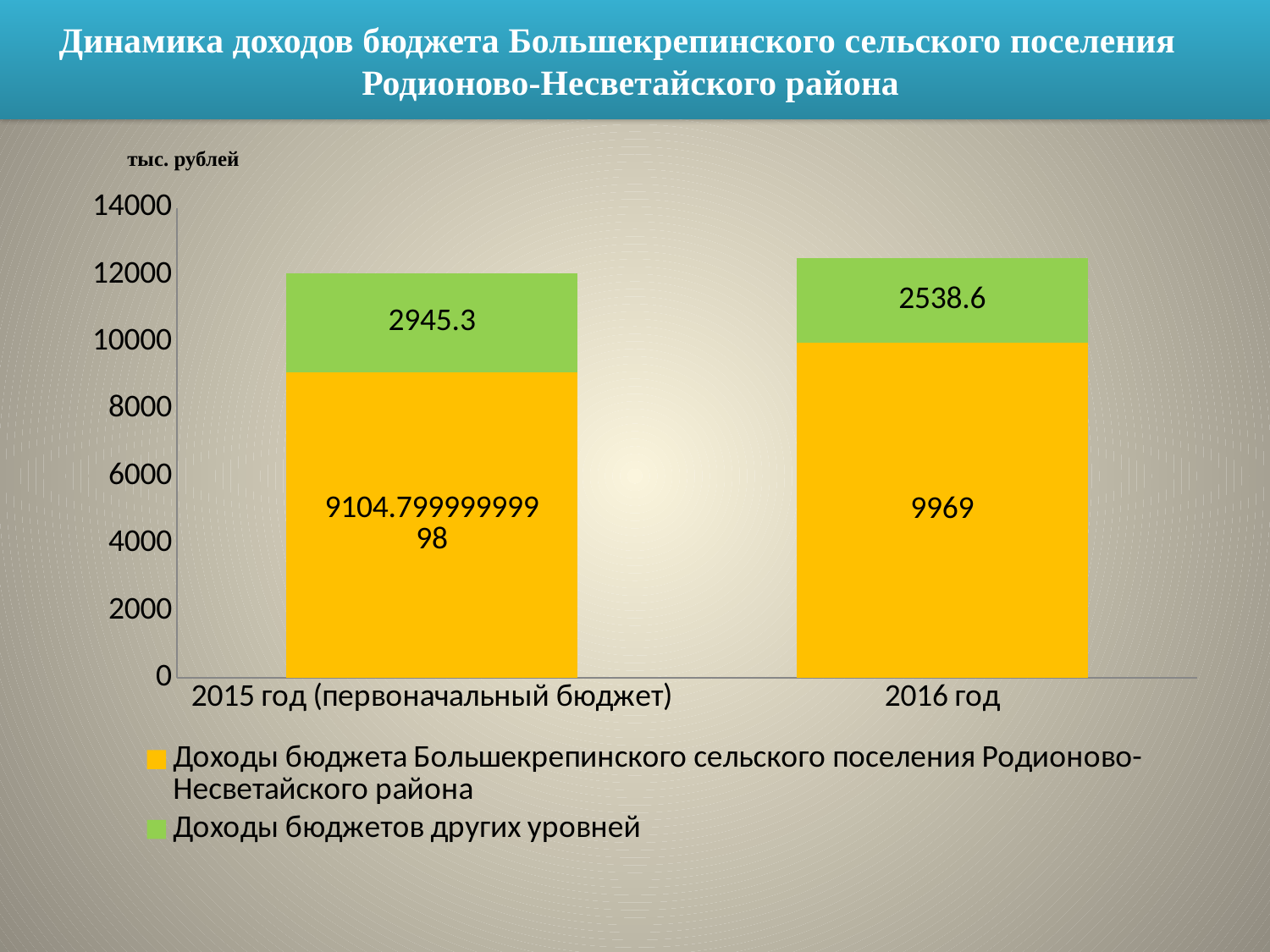
How many series does the legend list? 2 What is the value of 'Доходы бюджета Большекрепинского сельского поселения Родионово-Несветайского района' for 2015 год (первоначальный бюджет)? 9104.79999999998 Which year has the higher value for 'Доходы бюджетов других уровней'? 2015 год (первоначальный бюджет) What unit is indicated above the y axis? тыс. рублей How many categories are shown on the x axis? 2 What is the value of 'Доходы бюджетов других уровней' for 2015 год (первоначальный бюджет)? 2945.3 What is the value of 'Доходы бюджета Большекрепинского сельского поселения Родионово-Несветайского района' for 2016 год? 9969 What is the difference between the 'Доходы бюджетов других уровней' values for 2015 and 2016? 406.7 What type of chart is shown on the slide? Stacked bar chart Which year has the lower value for 'Доходы бюджета Большекрепинского сельского поселения Родионово-Несветайского района'? 2015 год (первоначальный бюджет) What is the value of 'Доходы бюджетов других уровней' for 2016 год? 2538.6 What is the total of the stacked bar for 2016 год? 12507.6